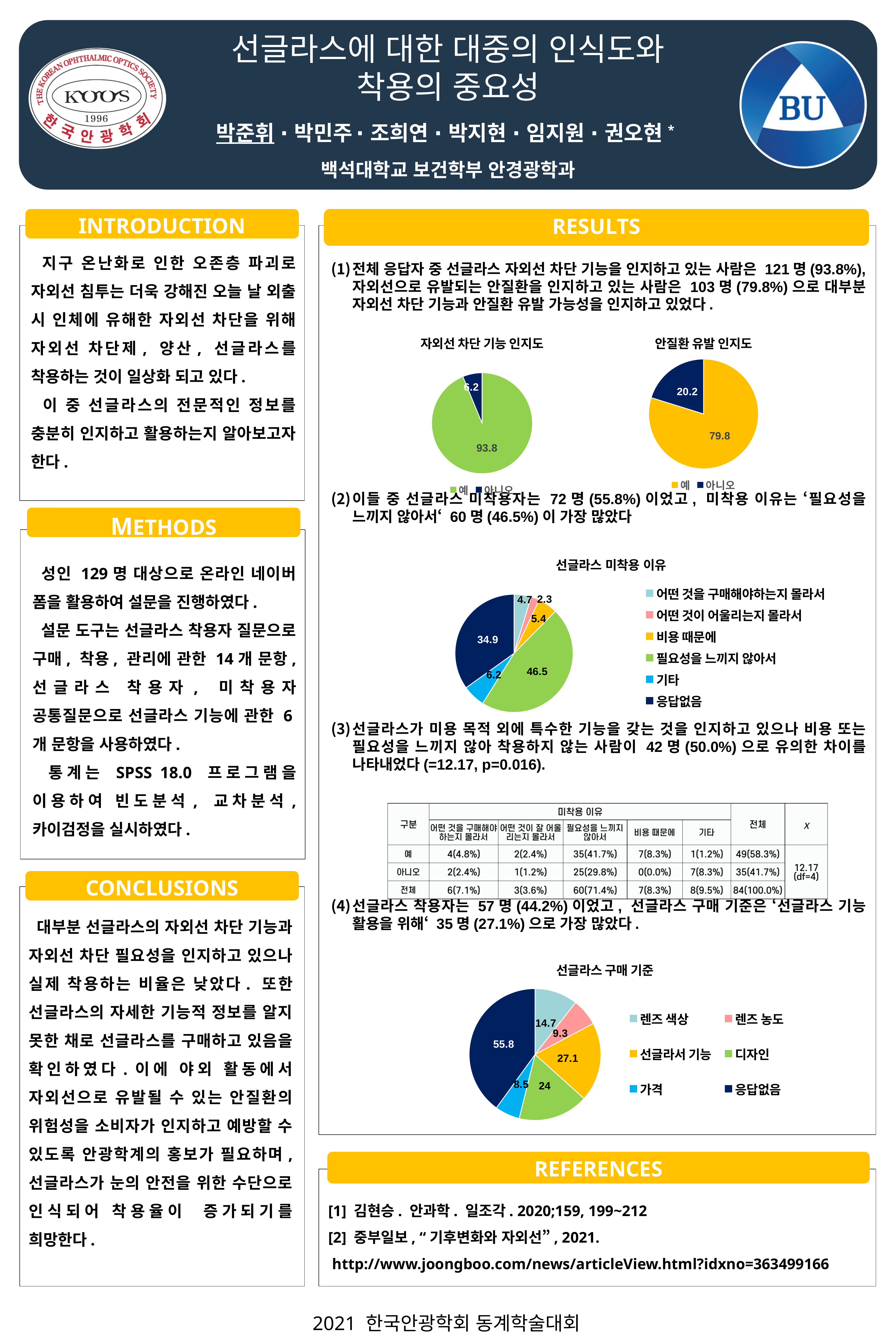
In the '선글라스 구매 기준' pie chart, what value is shown for '디자인'? 24 What type of chart is used for '선글라스 구매 기준'? Pie chart In the '선글라스 구매 기준' pie chart, what value is shown for '응답없음'? 55.8 In the '선글라스 미착용 이유' pie chart, what value is shown for '비용 때문에'? 5.4 In the '선글라스 미착용 이유' pie chart, which category has the largest slice? 필요성을 느끼지 않아서 In the '선글라스 구매 기준' pie chart, which is larger, '렌즈 색상' or '렌즈 농도'? 렌즈 색상 In the '자외선 차단 기능 인지도' pie chart, what value is shown for '예'? 93.8 In the '안질환 유발 인지도' pie chart, what is the difference between the '예' and '아니오' values? 59.6 How many categories does the legend of the '선글라스 미착용 이유' pie chart list? 6 In the '안질환 유발 인지도' pie chart, what value is shown for '아니오'? 20.2 In the '자외선 차단 기능 인지도' pie chart, what value is shown for '아니오'? 6.2 In the '선글라스 미착용 이유' pie chart, which category has the smallest slice? 어떤 것이 어울리는지 몰라서